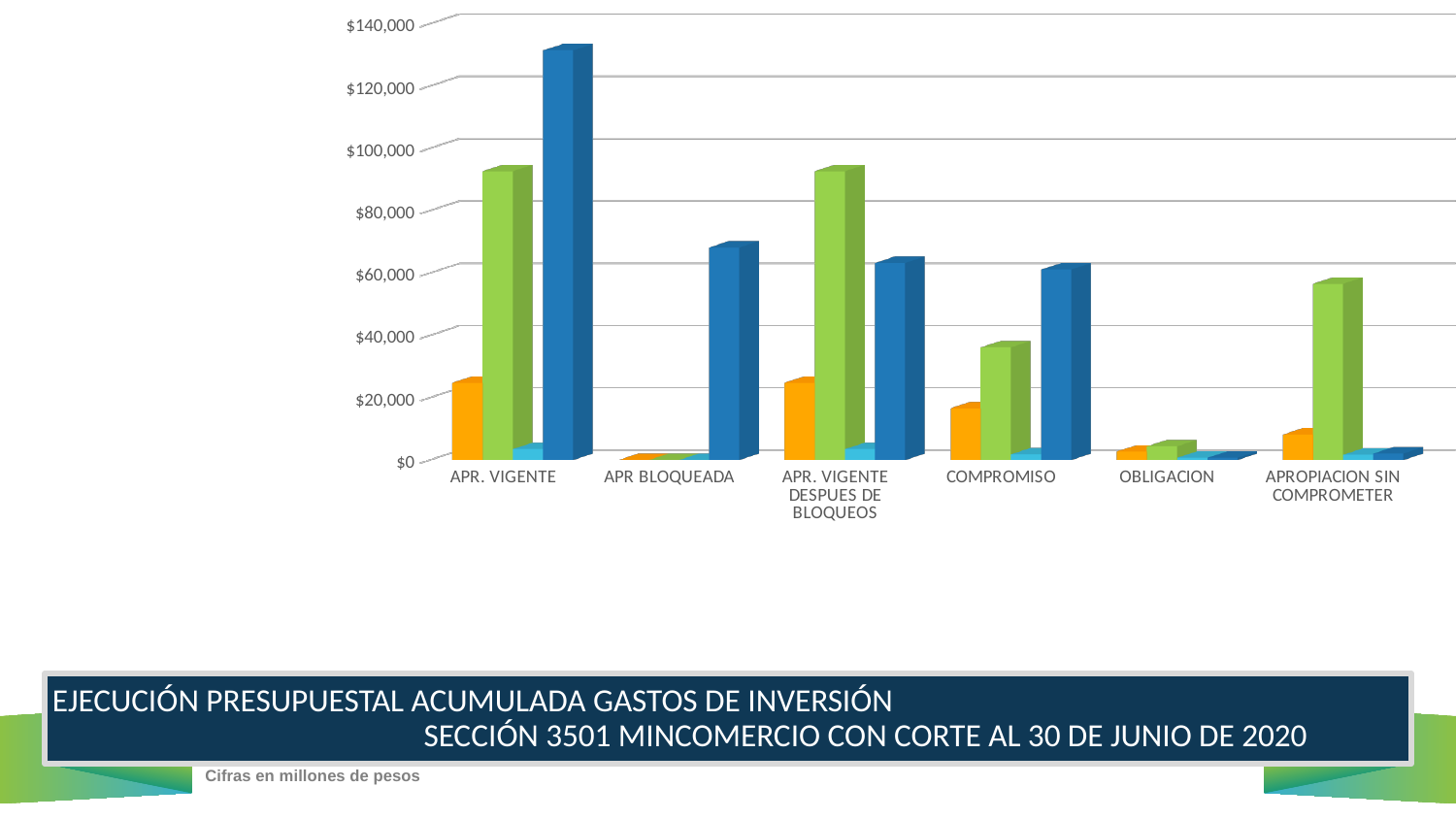
Is the dark blue bar for APR BLOQUEADA greater or less than $60,000? greater What is the highest value shown on the vertical axis of the chart? $140,000 Which is larger: the green bar for COMPROMISO or the green bar for APROPIACION SIN COMPROMETER? APROPIACION SIN COMPROMETER How many categories are shown along the x axis of the chart? 6 Is the green bar for COMPROMISO greater or less than $40,000? less Which category has the lowest dark blue bar? OBLIGACION Is the dark blue bar for APR. VIGENTE greater or less than $120,000? greater Which category has the tallest bar in the chart? APR. VIGENTE What kind of chart is shown on the slide? bar chart